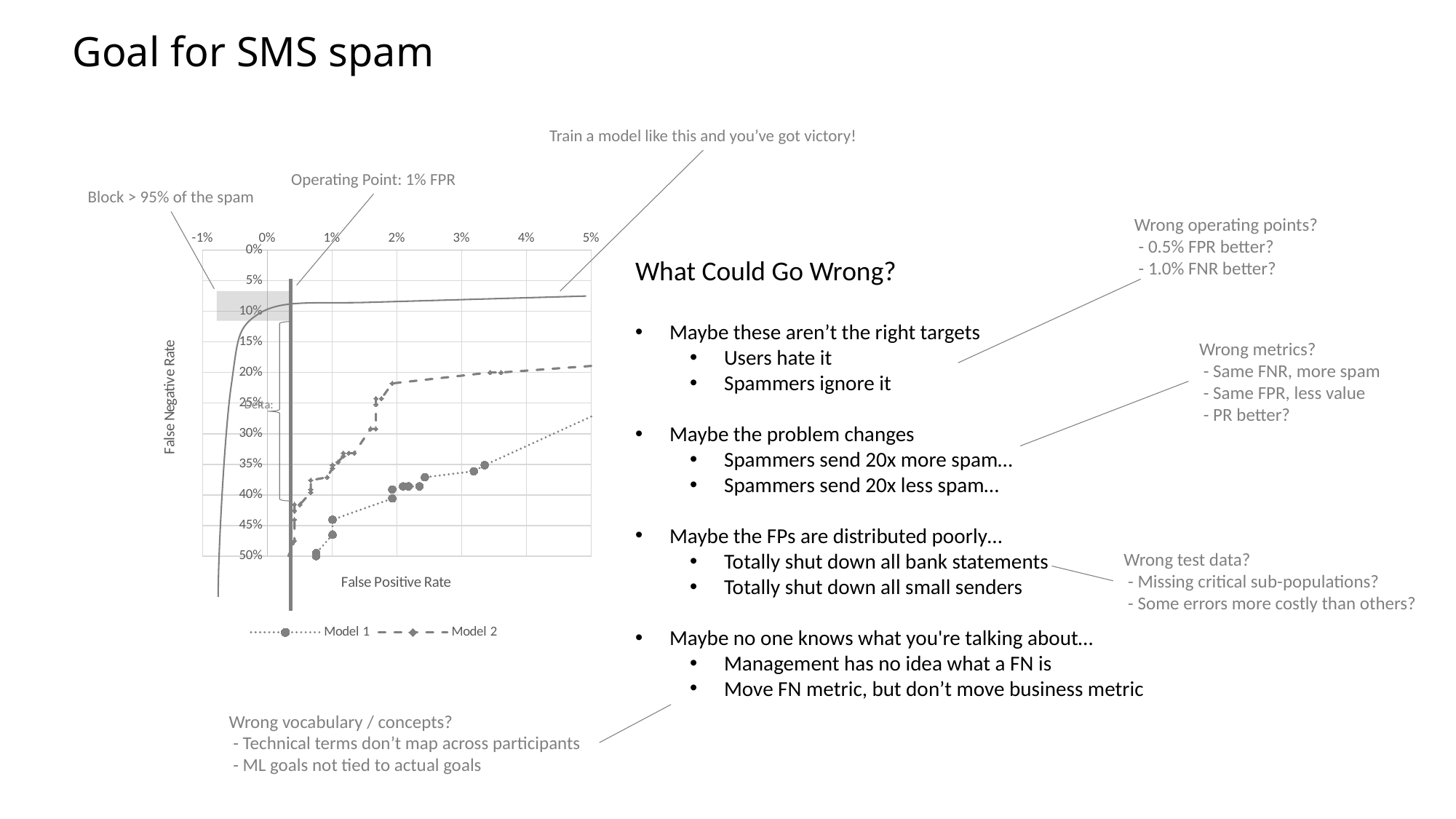
Is the False Negative Rate for Model 1 at a 1% False Positive Rate greater or less than 40%? greater At a False Positive Rate of 3%, which series has the lower False Negative Rate, Model 1 or Model 2? Model 2 Is the False Negative Rate for Model 2 at a 1% False Positive Rate greater or less than 40%? less As the False Positive Rate increases along the x axis, does the False Negative Rate for Model 2 rise or fall? fall What kind of chart is shown on the slide? line chart What is the title of the chart's vertical axis? False Negative Rate What is the highest value shown on the chart's x axis? 5% As the False Positive Rate increases along the x axis, does the False Negative Rate for Model 1 rise or fall? fall What are the names of the two series in the chart legend? Model 1 and Model 2 Is the False Negative Rate for Model 1 at a 5% False Positive Rate greater or less than 25%? greater How many series does the chart legend list? 2